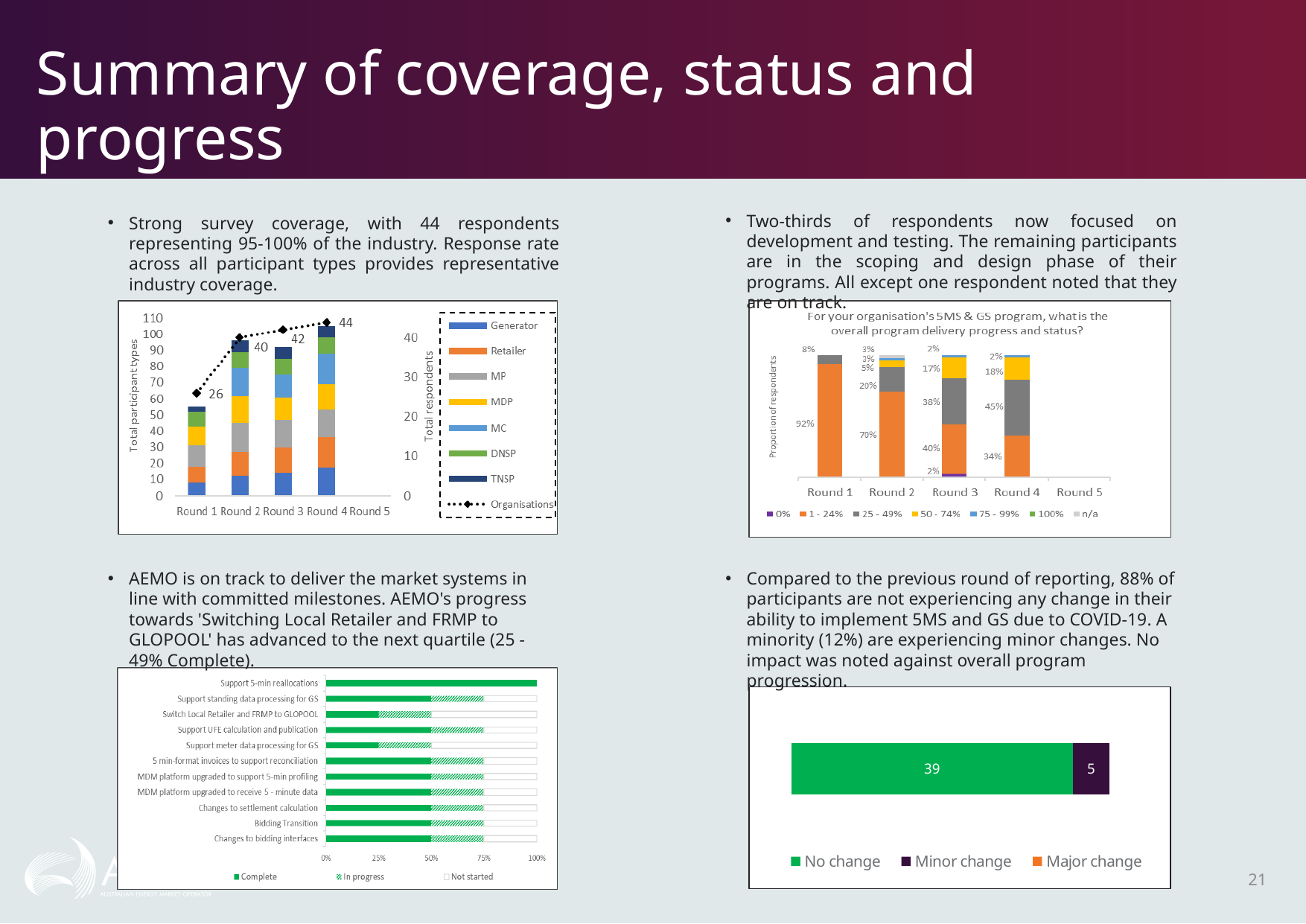
In the top-left chart of total participant types and respondents, what is the difference between the Organisations values for Round 3 and Round 2? 2 In the chart titled 'For your organisation's 5MS & GS program, what is the overall program delivery progress and status?', what is the value of the 25 - 49% segment for Round 4? 45% In the chart titled 'For your organisation's 5MS & GS program, what is the overall program delivery progress and status?', how many entries does the legend list? 7 In the bottom-right chart with the legend No change, Minor change and Major change, what is the total of the stacked bar? 44 In the chart titled 'For your organisation's 5MS & GS program, what is the overall program delivery progress and status?', which is larger for Round 3: the 1 - 24% segment or the 25 - 49% segment? 1 - 24% In the top-left chart of total participant types and respondents, what is the Organisations value for Round 1? 26 In the chart titled 'For your organisation's 5MS & GS program, what is the overall program delivery progress and status?', what is the value of the 1 - 24% segment for Round 1? 92% In the bottom-left chart of AEMO progress, how many categories are listed on the vertical axis? 11 In the top-left chart of total participant types and respondents, what is the Organisations value for Round 4? 44 In the bottom-right chart with the legend No change, Minor change and Major change, what is the value for No change? 39 In the top-left chart of total participant types and respondents, how many entries does the legend list? 8 In the top-left chart of total participant types and respondents, do the Organisations values rise or fall from Round 1 to Round 4? rise